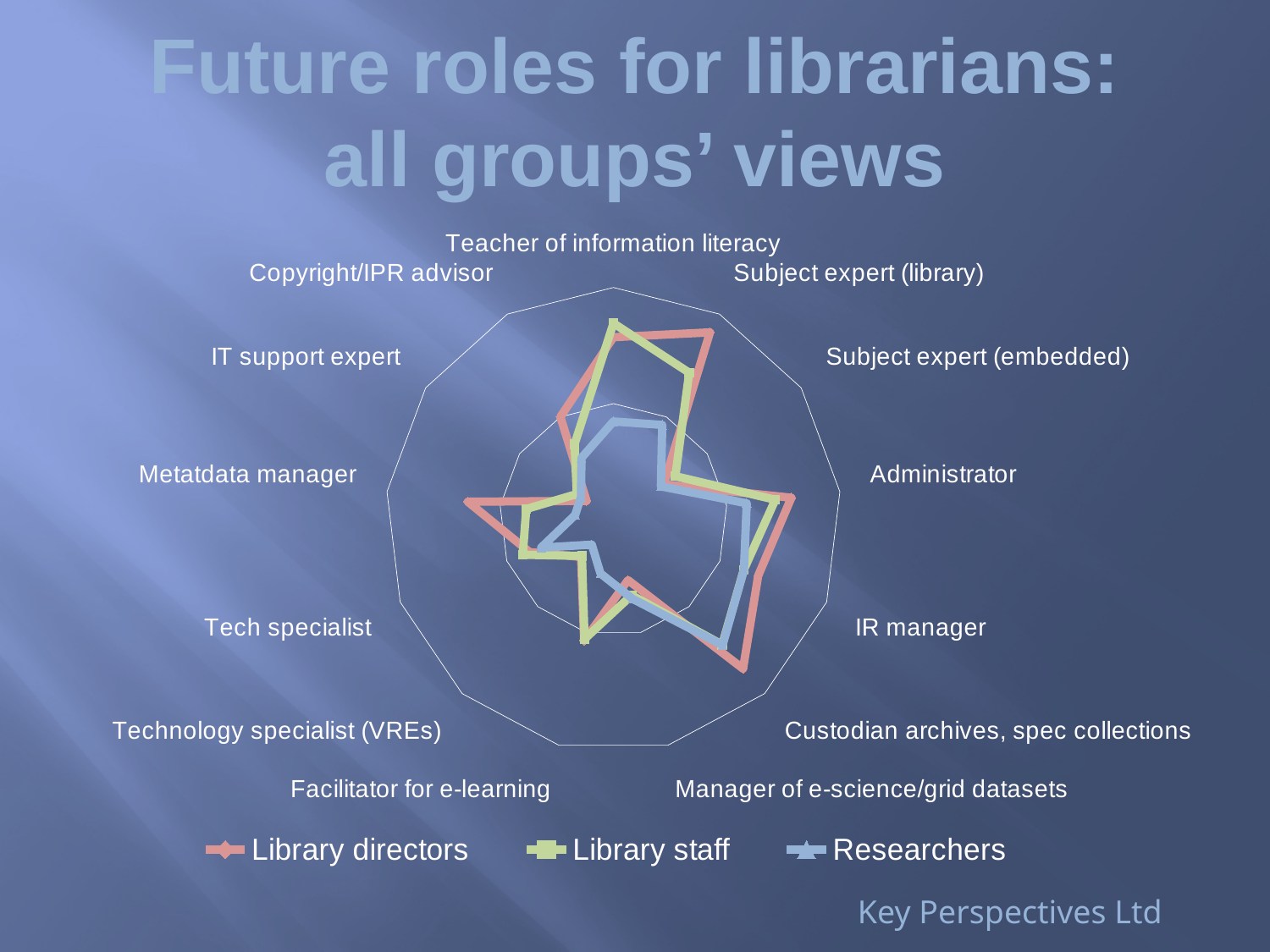
For Teacher of information literacy, which series has the larger value: Library staff or Researchers? Library staff For Metatdata manager, which series has the larger value: Library directors or Researchers? Library directors Which groups are listed in the chart legend? Library directors, Library staff, Researchers What kind of chart is shown on the slide? Radar chart For which role does the Library staff series reach its highest value? Teacher of information literacy For Administrator, which series has the larger value: Library directors or Researchers? Library directors How many series does the legend list? 3 How many future roles (categories) are plotted around the radar chart? 13 For which role does the Researchers series reach its highest value? Custodian archives, spec collections What is the title of the slide containing the chart? Future roles for librarians: all groups' views